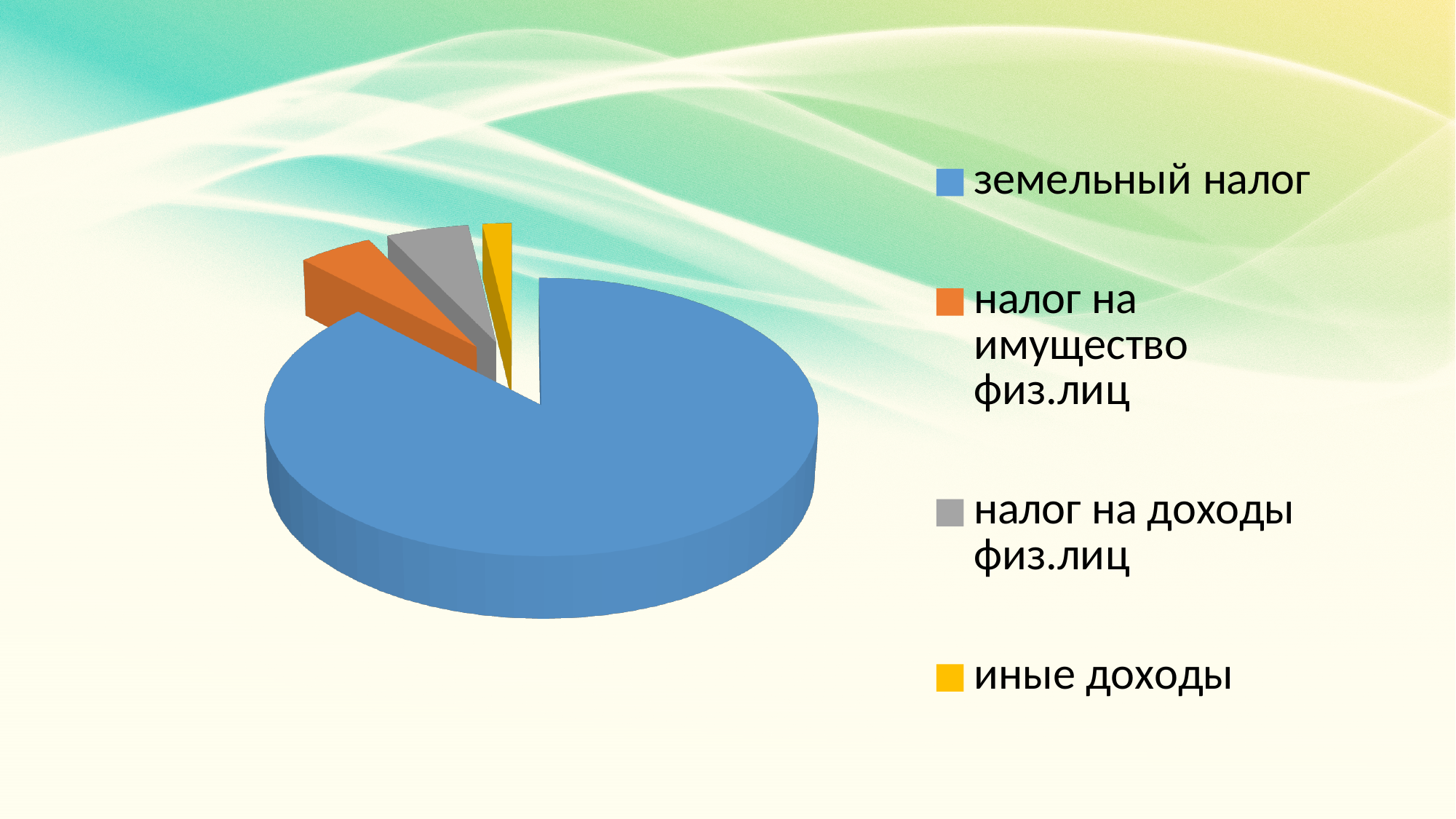
Which slice is larger: налог на доходы физ.лиц or иные доходы? налог на доходы физ.лиц Does the земельный налог slice take up more or less than half of the pie? more How many categories does the pie chart have? 4 Which slice is larger: налог на имущество физ.лиц or иные доходы? налог на имущество физ.лиц What kind of chart is shown on the slide? pie chart Which category has the smallest slice of the pie? иные доходы What colour is the slice for земельный налог? blue Which slice is larger: земельный налог or налог на имущество физ.лиц? земельный налог Which category has the largest slice of the pie? земельный налог Which category is shown in orange in the legend? налог на имущество физ.лиц